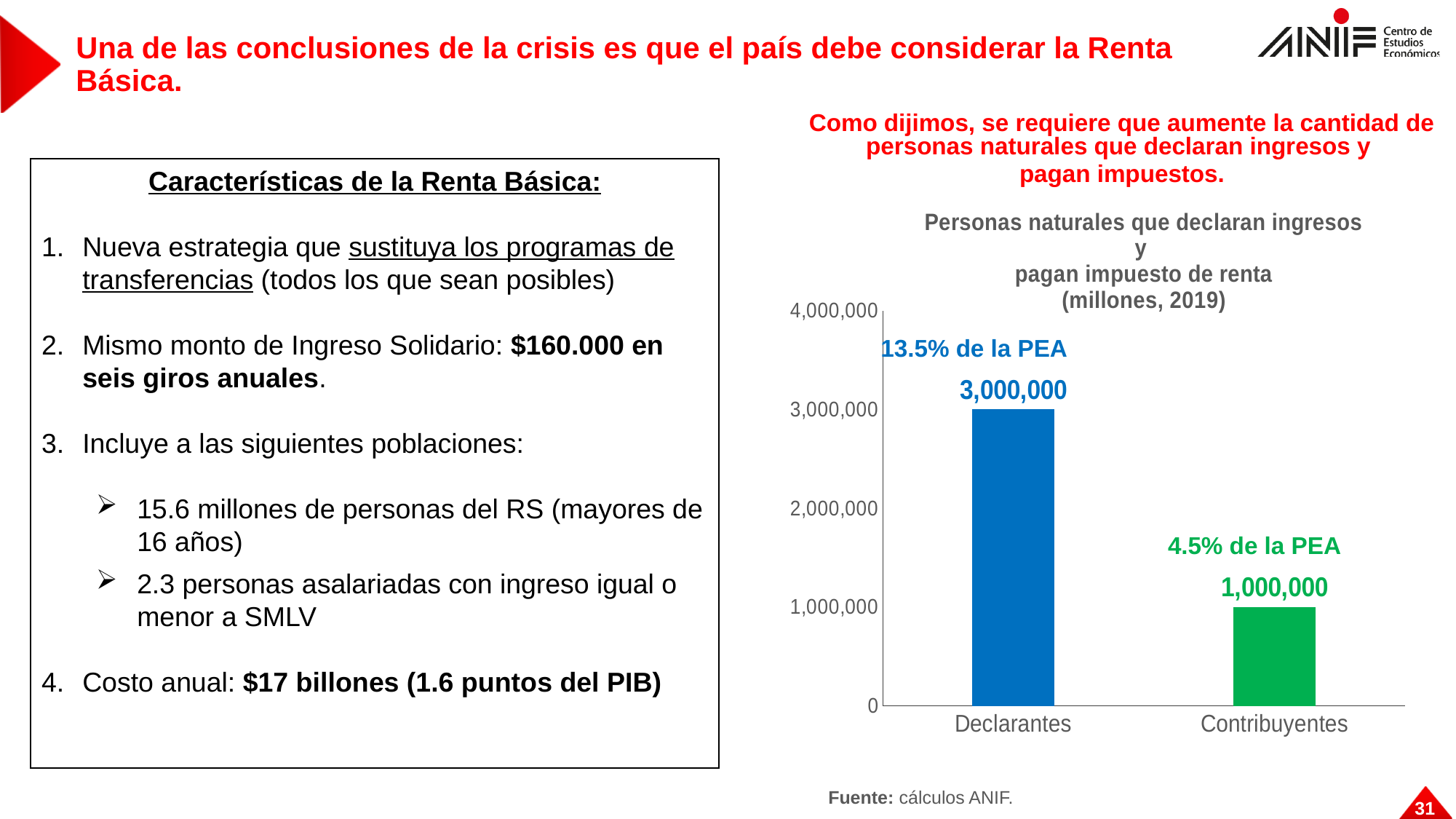
What kind of chart is shown on the slide? bar chart What percentage of the PEA is labelled above the Contribuyentes bar? 4.5% de la PEA What is the difference between the values for Declarantes and Contribuyentes? 2,000,000 Is the value for Contribuyentes greater or less than 2,000,000? less Which is larger, the value for Declarantes or the value for Contribuyentes? Declarantes Which category has the lowest value? Contribuyentes What is the highest value shown on the y axis of the chart? 4,000,000 What percentage of the PEA is labelled above the Declarantes bar? 13.5% de la PEA How many categories are shown on the x axis of the chart? 2 Which category has the highest value? Declarantes What is the value for Declarantes? 3,000,000 What is the value for Contribuyentes? 1,000,000